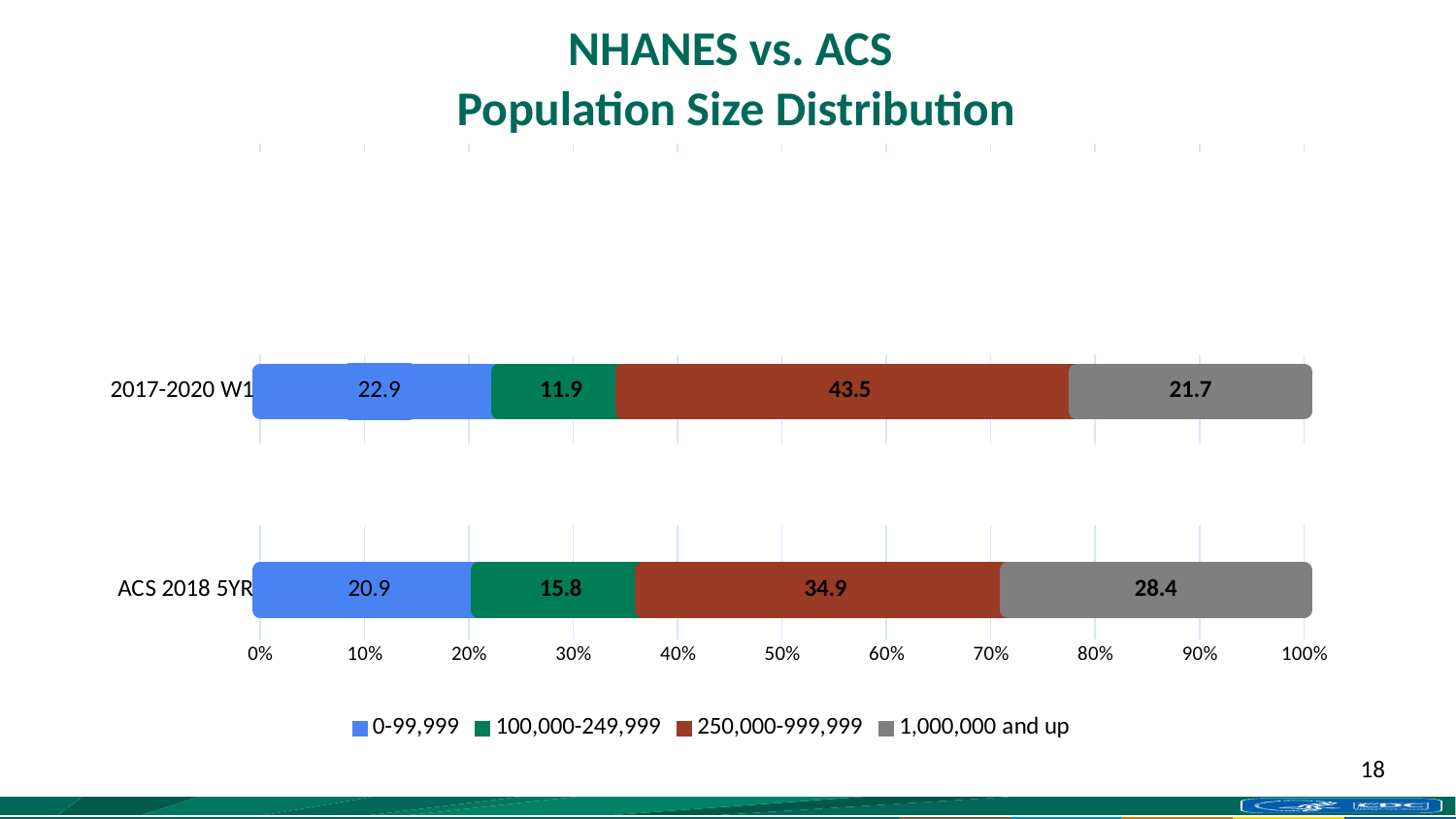
Which series has the largest value in the 2017-2020 W1 bar? 250,000-999,999 What is the value for the 0-99,999 series in the ACS 2018 5YR bar? 20.9 What is the title of the chart? NHANES vs. ACS Population Size Distribution What kind of chart is shown on the slide? Stacked bar chart What is the value for the 100,000-249,999 series in the 2017-2020 W1 bar? 11.9 How many series does the legend list? 4 What is the difference between the 250,000-999,999 values for 2017-2020 W1 and ACS 2018 5YR? 8.6 What is the value for the 250,000-999,999 series in the 2017-2020 W1 bar? 43.5 What is the value for the 1,000,000 and up series in the ACS 2018 5YR bar? 28.4 Which bar has the larger value for the 1,000,000 and up series, 2017-2020 W1 or ACS 2018 5YR? ACS 2018 5YR How many bars (categories) are shown in the chart? 2 Which series has the smallest value in the ACS 2018 5YR bar? 100,000-249,999